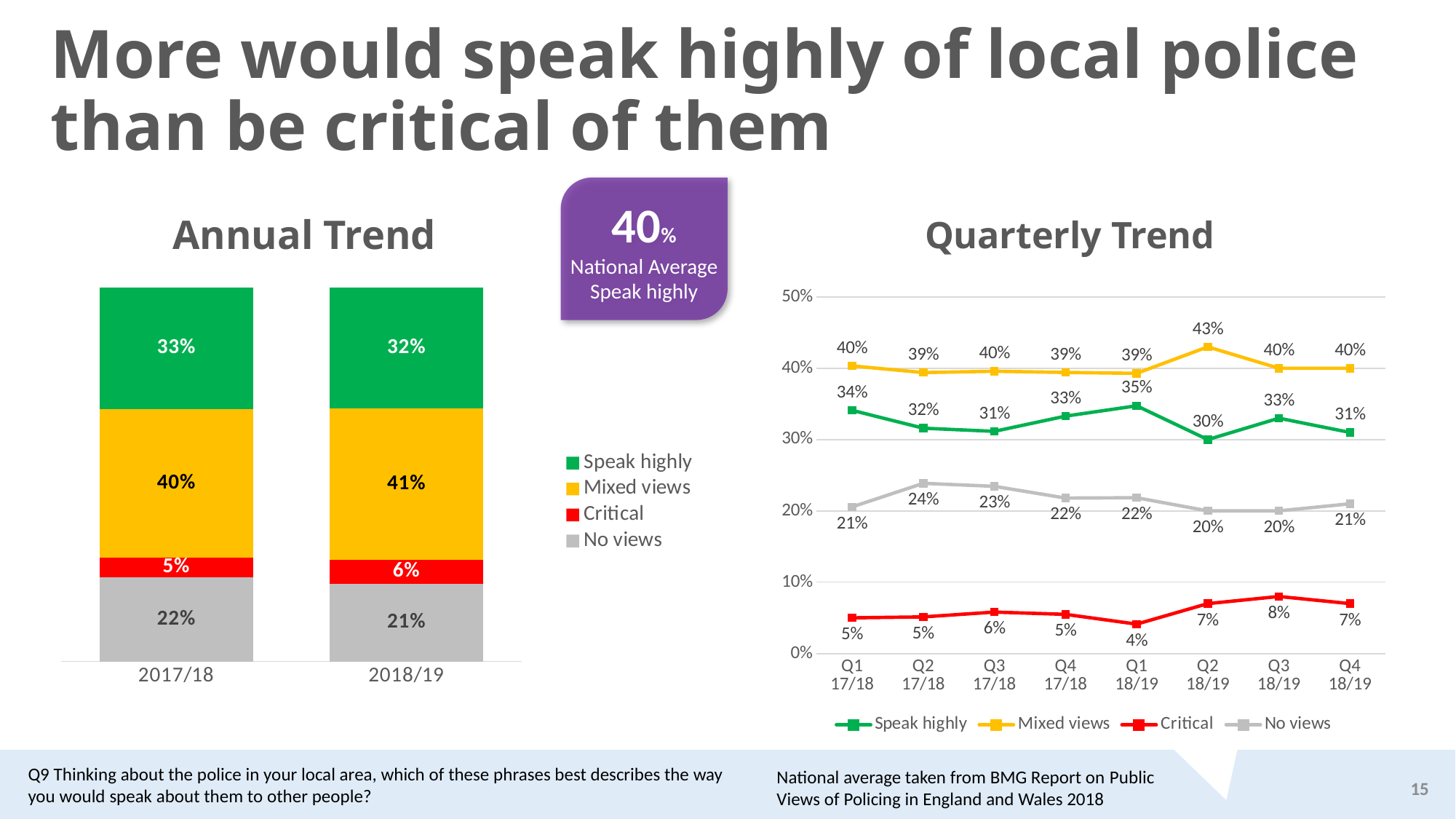
In the Quarterly Trend chart, which is larger in Q4 18/19: Speak highly or No views? Speak highly In the Quarterly Trend chart, what is the Critical value for Q1 18/19? 4% In the Annual Trend chart, what percentage had Mixed views in 2018/19? 41% In the Annual Trend chart, what is the total of the stacked bar for 2017/18? 100% In the Annual Trend chart, what is the difference between the Speak highly values for 2017/18 and 2018/19? 1% In the Quarterly Trend chart, what is the Mixed views value for Q2 18/19? 43% What kind of chart is the Annual Trend chart? Stacked bar chart In the Quarterly Trend chart, how many series does the legend list? 4 In the Annual Trend chart, what percentage were Critical in 2017/18? 5% In the Quarterly Trend chart, in which quarter is the Critical series at its highest? Q3 18/19 In the Quarterly Trend chart, in which quarter is the Speak highly series at its highest? Q1 18/19 In the Quarterly Trend chart, how many quarters are shown on the x axis? 8